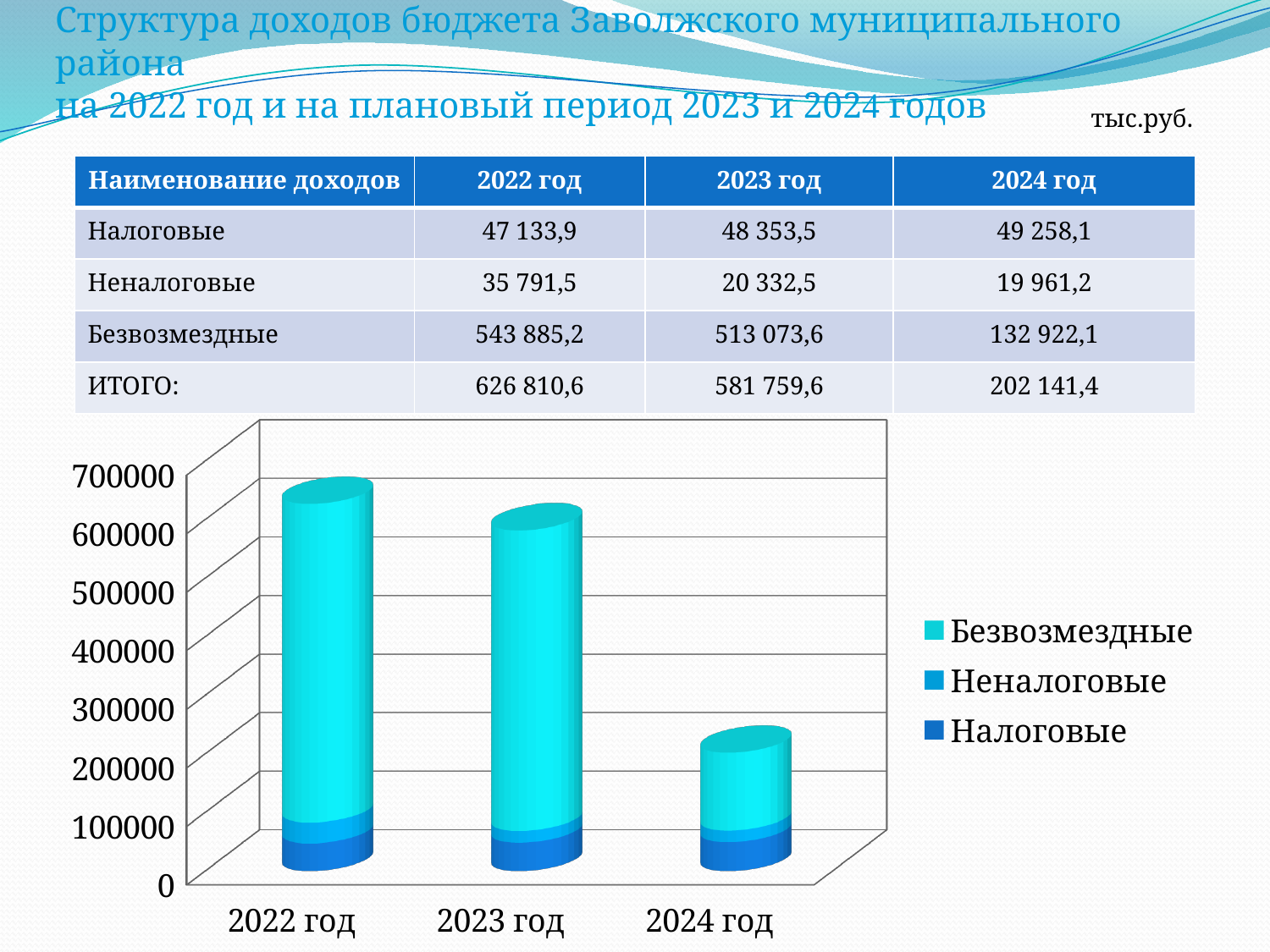
How many years (categories) are shown on the x axis of the chart? 3 Do the total bar heights rise or fall from 2022 год to 2024 год? fall According to the table, what is the value of Безвозмездные for 2024 год? 132 922,1 Which year has the shortest stacked bar in the chart? 2024 год What kind of chart is shown at the bottom of the slide? bar chart How many series does the chart legend list? 3 Is the total height of the bar for 2023 год greater or less than 500000? greater According to the table, what is the total (ИТОГО) for 2022 год? 626 810,6 Which year has the tallest stacked bar in the chart? 2022 год Is the total height of the bar for 2024 год greater or less than 300000? less Which series is listed first (at the top) in the chart legend? Безвозмездные In 2023 год, which is larger: Налоговые or Неналоговые? Налоговые